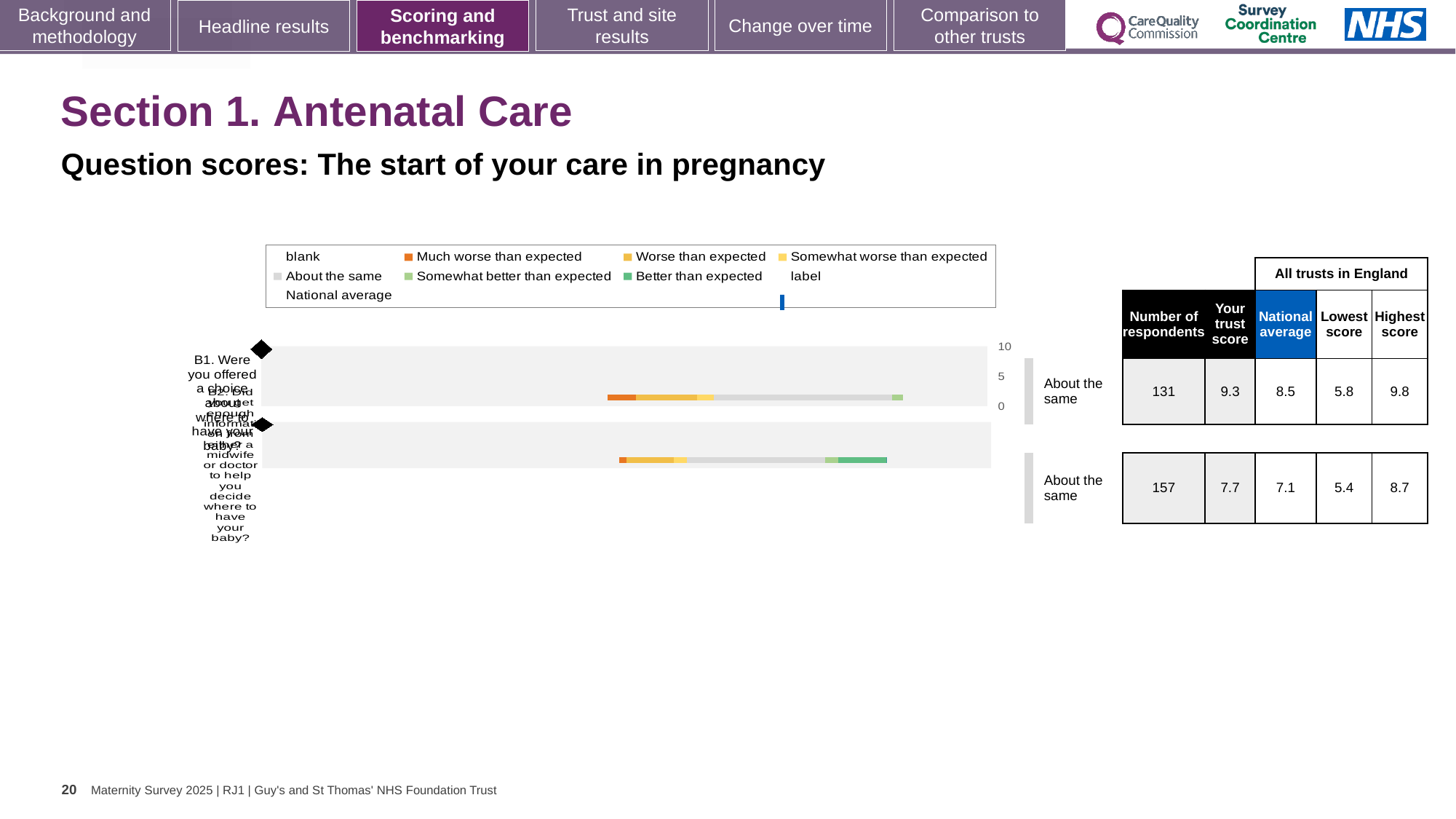
How many respondents answered question B1? 131 What kind of chart is shown on the slide? Bar chart What is the subtitle describing the question scores shown? Question scores: The start of your care in pregnancy Which question has more respondents, B1 or B2? B2 What is the difference between the trust score and the national average for B1? 0.8 What is the national average for B2 (Did you get enough information from either a midwife or doctor to help you decide where to have your baby?)? 7.1 What is the title of the slide section above the chart? Section 1. Antenatal Care What is the trust score for B1 (Were you offered a choice about where to have your baby?)? 9.3 How many questions (bars) are plotted in the chart? 2 What is the lowest score across all trusts in England for B1? 5.8 What is the highest score across all trusts in England for B2? 8.7 Which question has the higher trust score, B1 or B2? B1